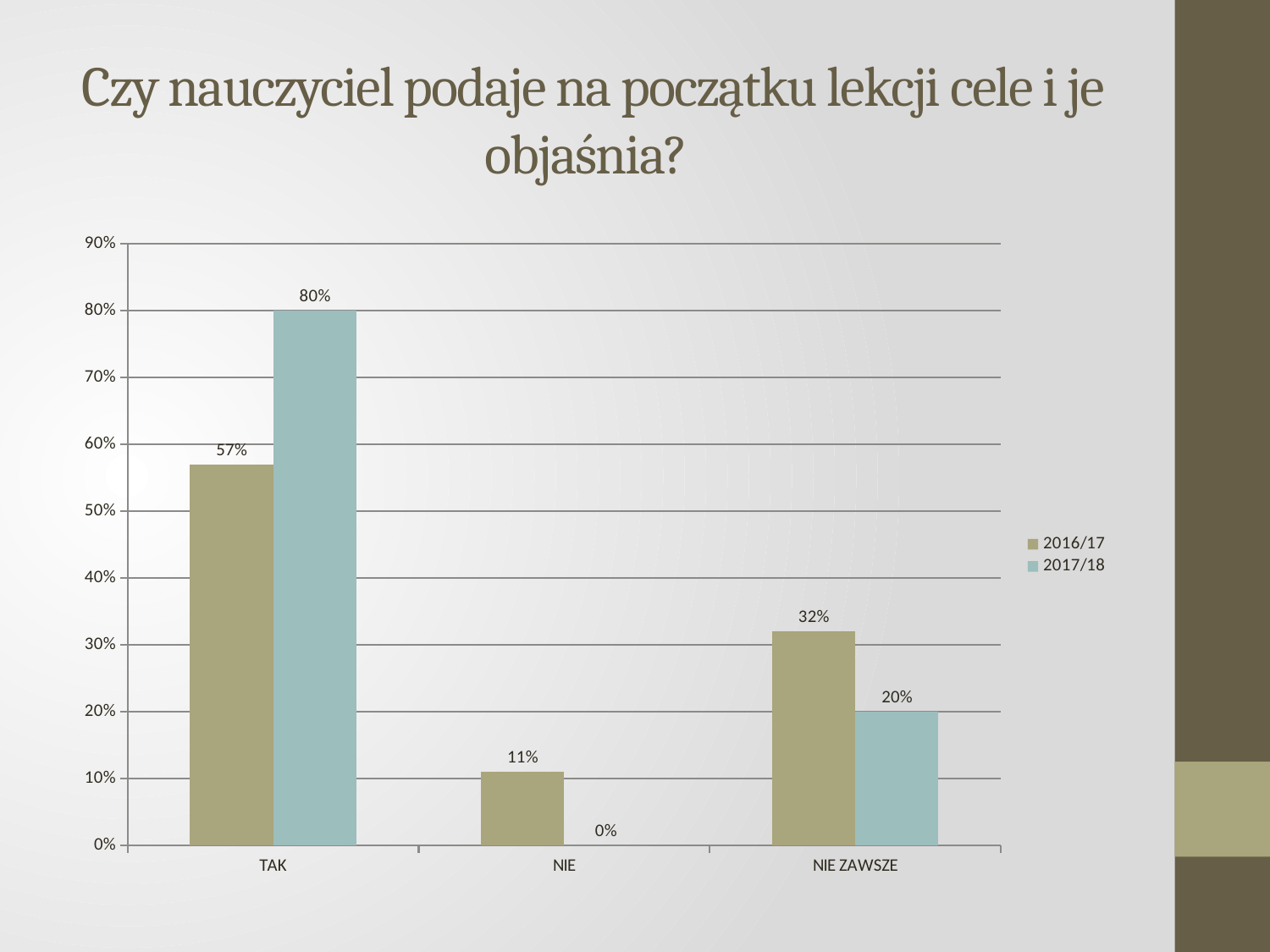
What is the value for TAK in the 2017/18 series? 80% What is the value for NIE in the 2016/17 series? 11% What kind of chart is shown on the slide? Bar chart Which category has the highest value in the 2017/18 series? TAK What is the difference between the 2016/17 and 2017/18 values for NIE ZAWSZE? 12% What is the value for NIE ZAWSZE in the 2017/18 series? 20% What is the difference between the 2017/18 and 2016/17 values for TAK? 23% How many categories are shown on the x axis? 3 How many series does the legend list? 2 Which category has the lowest value in the 2016/17 series? NIE What is the value for TAK in the 2016/17 series? 57% Which is larger for NIE ZAWSZE: the 2016/17 value or the 2017/18 value? 2016/17